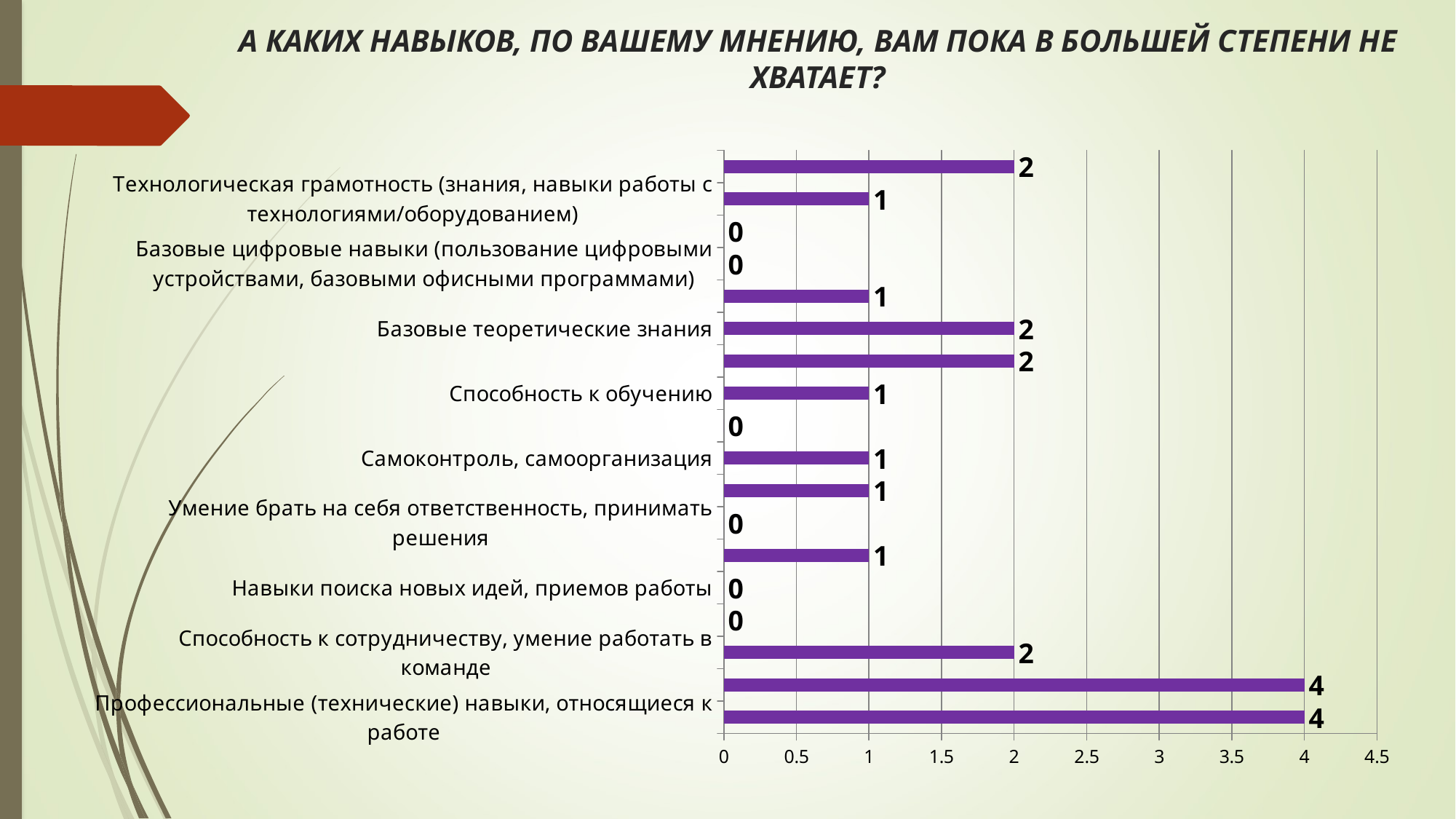
What is the value for Профессиональные (технические) навыки, относящиеся к работе? 4 What is the value for Самоконтроль, самоорганизация? 1 Which is larger: the value for Профессиональные (технические) навыки, относящиеся к работе or the value for Самоконтроль, самоорганизация? Профессиональные (технические) навыки, относящиеся к работе Which labeled category has the highest value? Профессиональные (технические) навыки, относящиеся к работе What kind of chart is shown on the slide? bar chart What is the maximum value shown on the horizontal axis? 4.5 How many bars are plotted in the chart? 18 What is the highest value shown by any bar in the chart? 4 What is the value for Базовые цифровые навыки (пользование цифровыми устройствами, базовыми офисными программами)? 0 What is the value for Навыки поиска новых идей, приемов работы? 0 What is the value for Базовые теоретические знания? 2 What is the difference between the values for Профессиональные (технические) навыки, относящиеся к работе and Базовые теоретические знания? 2